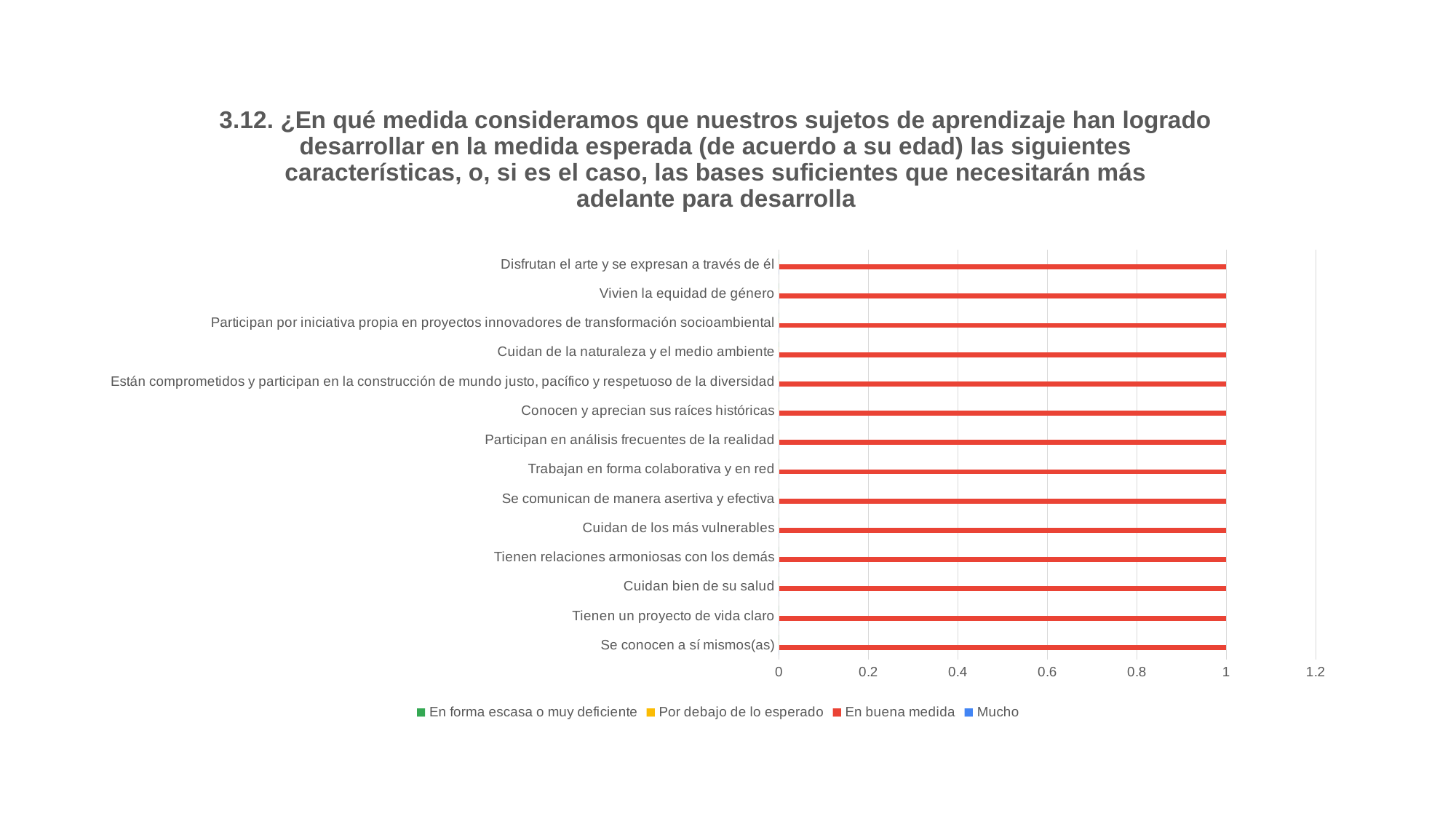
What is the value of the 'En buena medida' bar for 'Se conocen a sí mismos(as)'? 1 What kind of chart is shown on the slide? bar chart What is the difference between the 'En buena medida' values for 'Vivien la equidad de género' and 'Tienen un proyecto de vida claro'? 0 How many series does the legend list? 4 What is the highest value shown on the horizontal axis? 1.2 Which series in the legend is shown in red? En buena medida What is the value of the 'En buena medida' bar for 'Cuidan bien de su salud'? 1 What is the value of the 'En buena medida' bar for 'Disfrutan el arte y se expresan a través de él'? 1 Is the value for 'Trabajan en forma colaborativa y en red' greater or less than 0.8? greater Which series in the legend is shown in blue? Mucho Is the value for 'Cuidan de los más vulnerables' greater or less than 1.2? less How many categories are listed on the vertical axis of the chart? 14